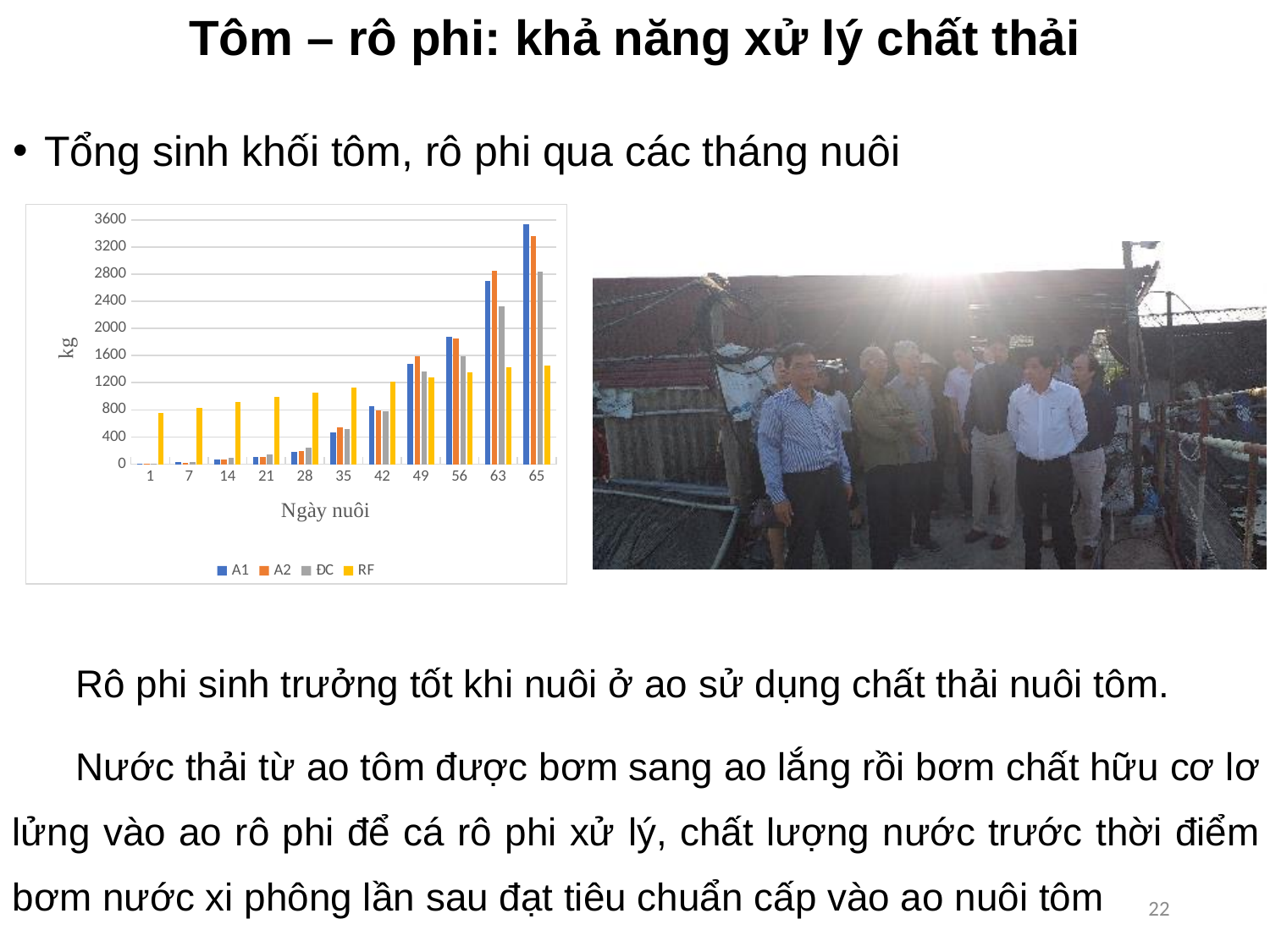
What kind of chart is shown on the slide? bar chart What is the label of the x axis of the chart? Ngày nuôi Is the value for RF at day 35 greater or less than 800? greater How many series does the chart legend list? 4 What is the label of the y axis of the chart? kg Do the values for series A1 rise or fall as the days increase along the x axis? rise Which series has the highest value at day 65? A1 How many categories (days) are shown on the x axis of the chart? 11 At which day does series A1 reach its highest value? 65 At day 28, which is larger: the value for RF or the value for A1? RF Is the value for A1 at day 65 greater or less than 3200? greater Which series has the highest value at day 1? RF